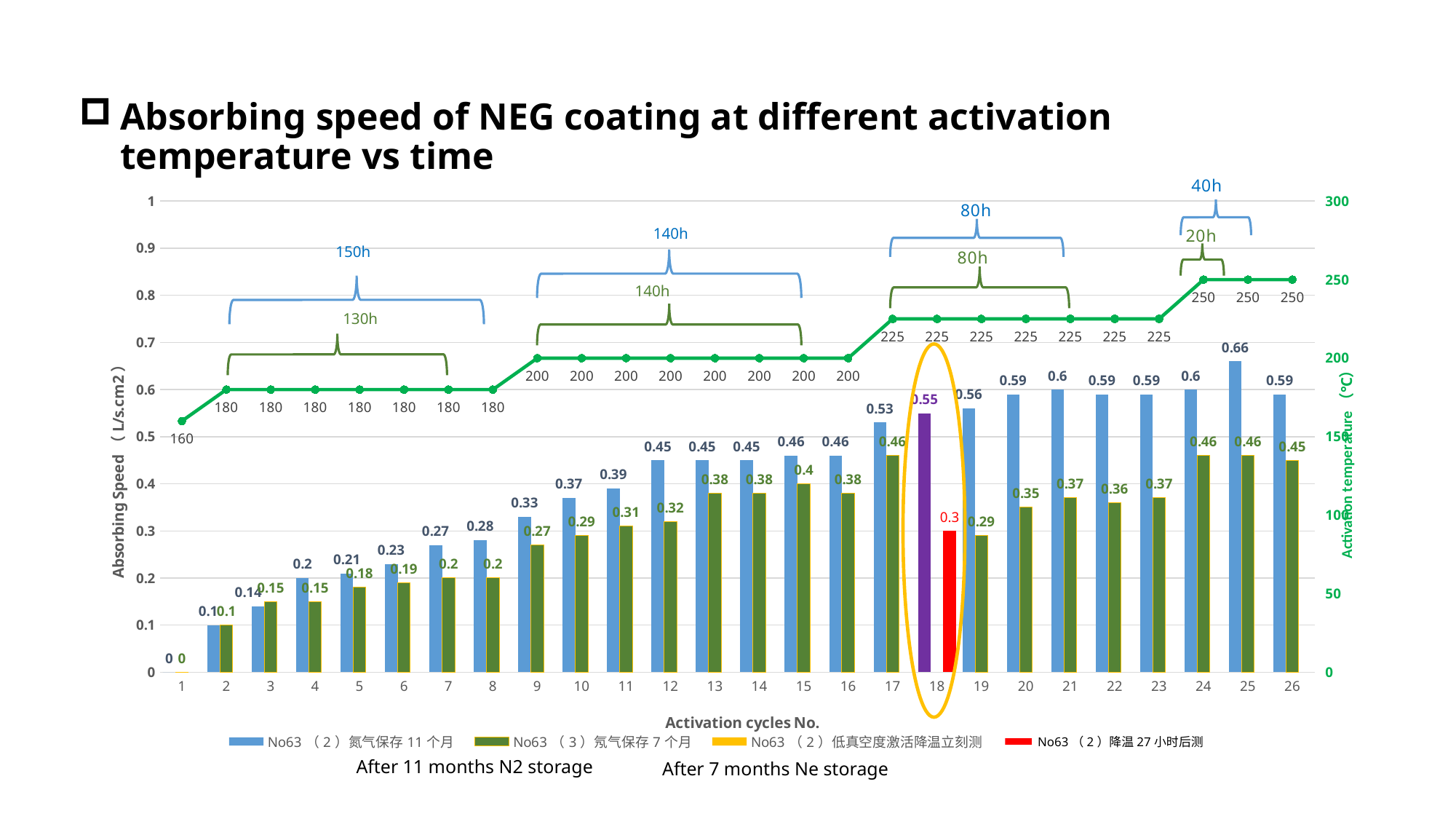
At which activation cycle number does the blue series reach its highest absorbing speed? 25 Do the blue bars generally rise or fall from activation cycle 1 to activation cycle 25? Rise What is the absorbing speed of the green series (No63 (3), after 7 months Ne storage) at activation cycle 15? 0.4 What kind of chart is shown on the slide? A bar chart with a line What is the activation temperature shown by the green line at activation cycle 1? 160 What is the activation temperature shown by the green line at activation cycle 24? 250 How many activation cycle numbers are shown on the x axis? 26 How many series does the legend list? 4 What is the difference between the blue bar and the green bar at activation cycle 25? 0.2 What is the absorbing speed of the blue series (No63 (2), after 11 months N2 storage) at activation cycle 17? 0.53 At activation cycle 12, which bar is taller, the blue one or the green one? The blue one What is the value of the red bar at activation cycle 18? 0.3